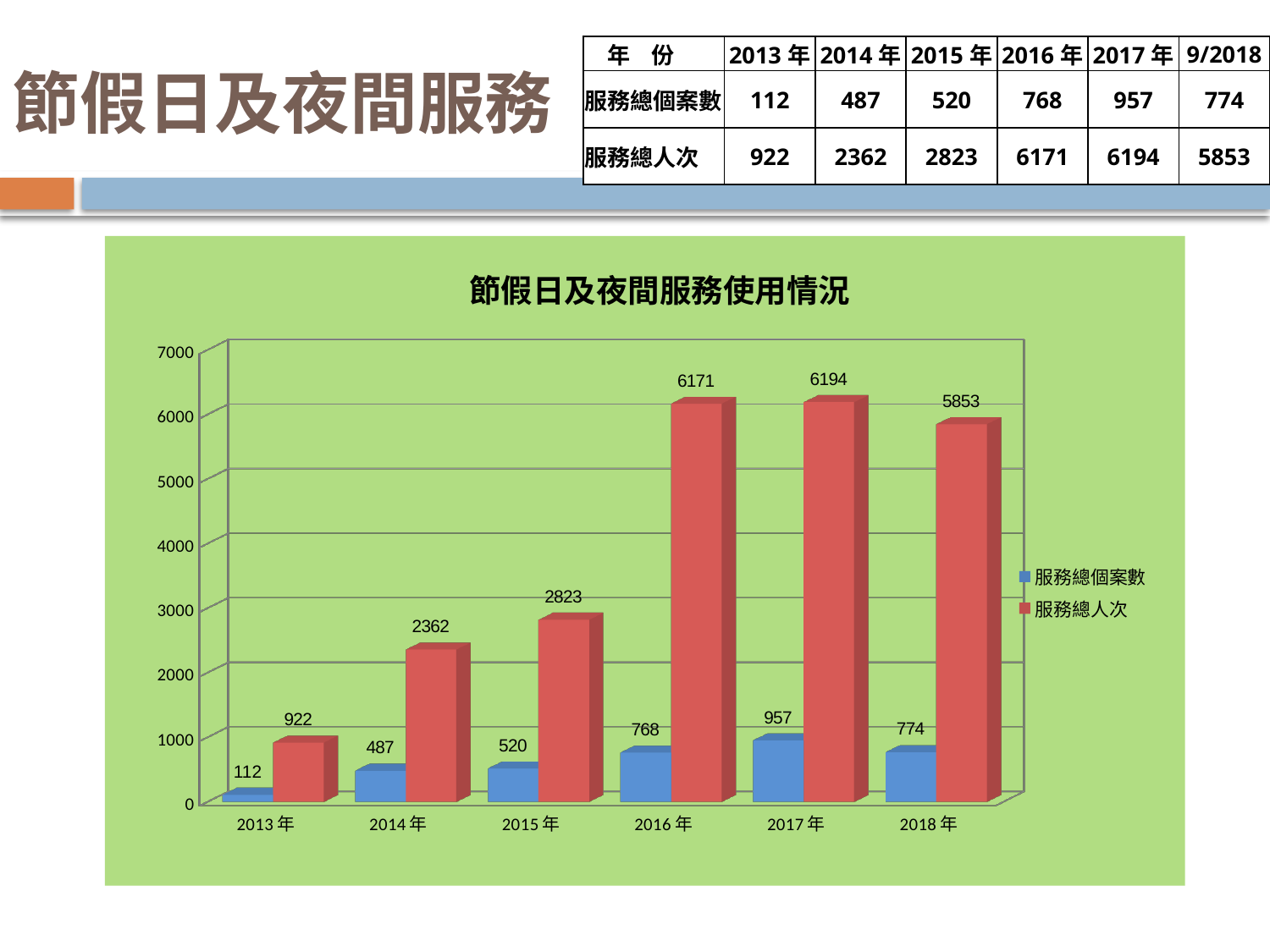
How many series does the chart legend list? 2 What kind of chart is shown on the slide? bar chart What is the value of 服務總個案數 for 2014年? 487 Which is larger: 服務總個案數 in 2017年 or in 2018年? 2017年 Is the value of 服務總人次 for 2014年 greater or less than 2000? greater How many years are shown on the x axis of the chart? 6 Which year has the highest 服務總人次? 2017年 What is the difference between 服務總人次 in 2016年 and 2015年? 3348 What is the title of the chart? 節假日及夜間服務使用情況 Which year has the lowest 服務總個案數? 2013年 What is the value of 服務總人次 for 2016年? 6171 Does 服務總個案數 rise or fall from 2013年 to 2017年? rise